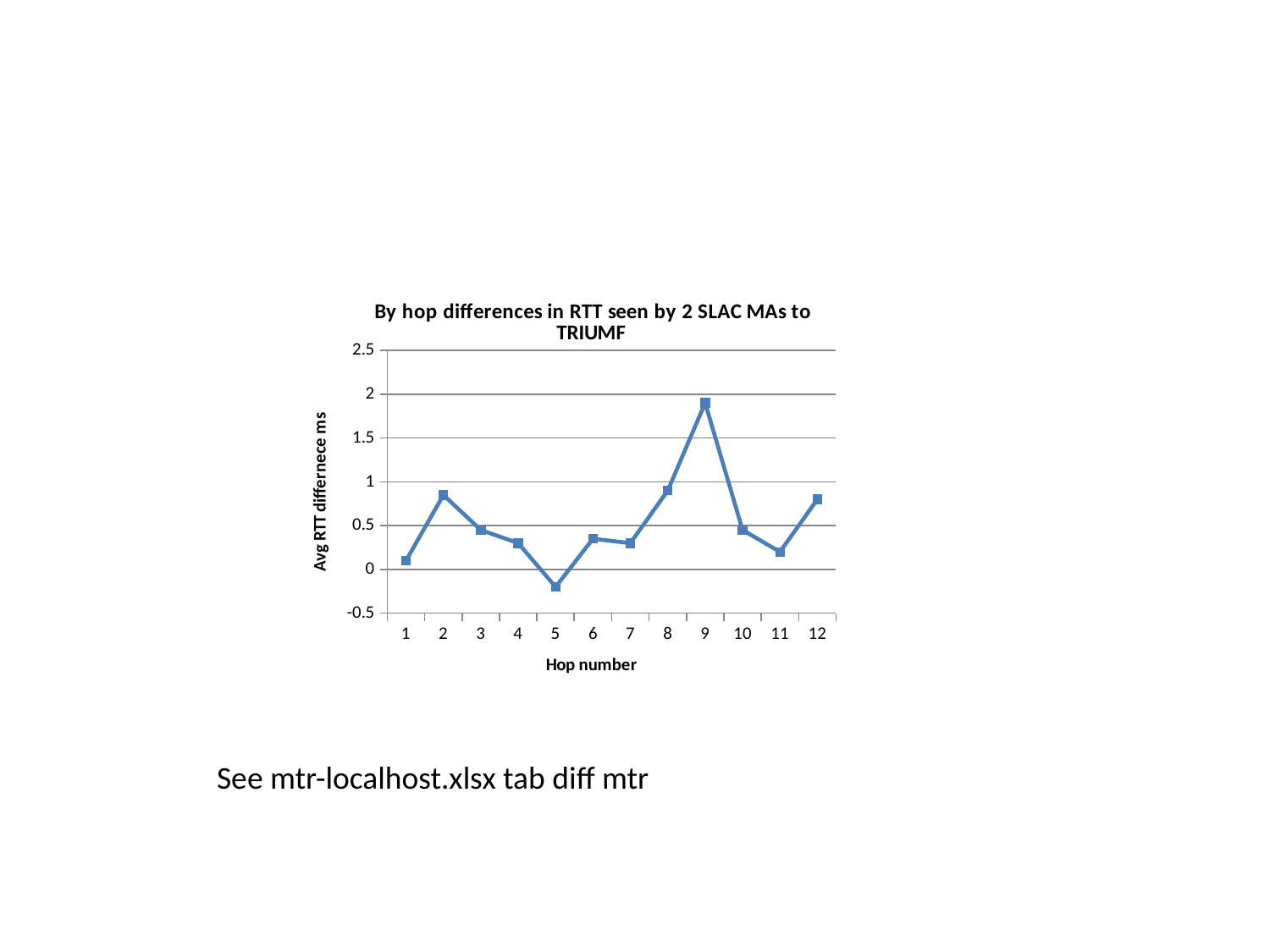
What is the title of the chart? By hop differences in RTT seen by 2 SLAC MAs to TRIUMF Which hop number has the lowest average RTT difference? 5 Is the value for hop 1 greater or less than 0.5? less Is the value for hop 9 greater or less than 1.5? greater Does the average RTT difference rise or fall from hop 9 to hop 10? fall Which hop number has the highest average RTT difference? 9 Is the value for hop 2 greater or less than 0.5? greater What is the label of the y axis? Avg RTT differnece ms What kind of chart is shown on the slide? line chart How many hop numbers are plotted along the x axis? 12 Which has a larger average RTT difference, hop 8 or hop 11? hop 8